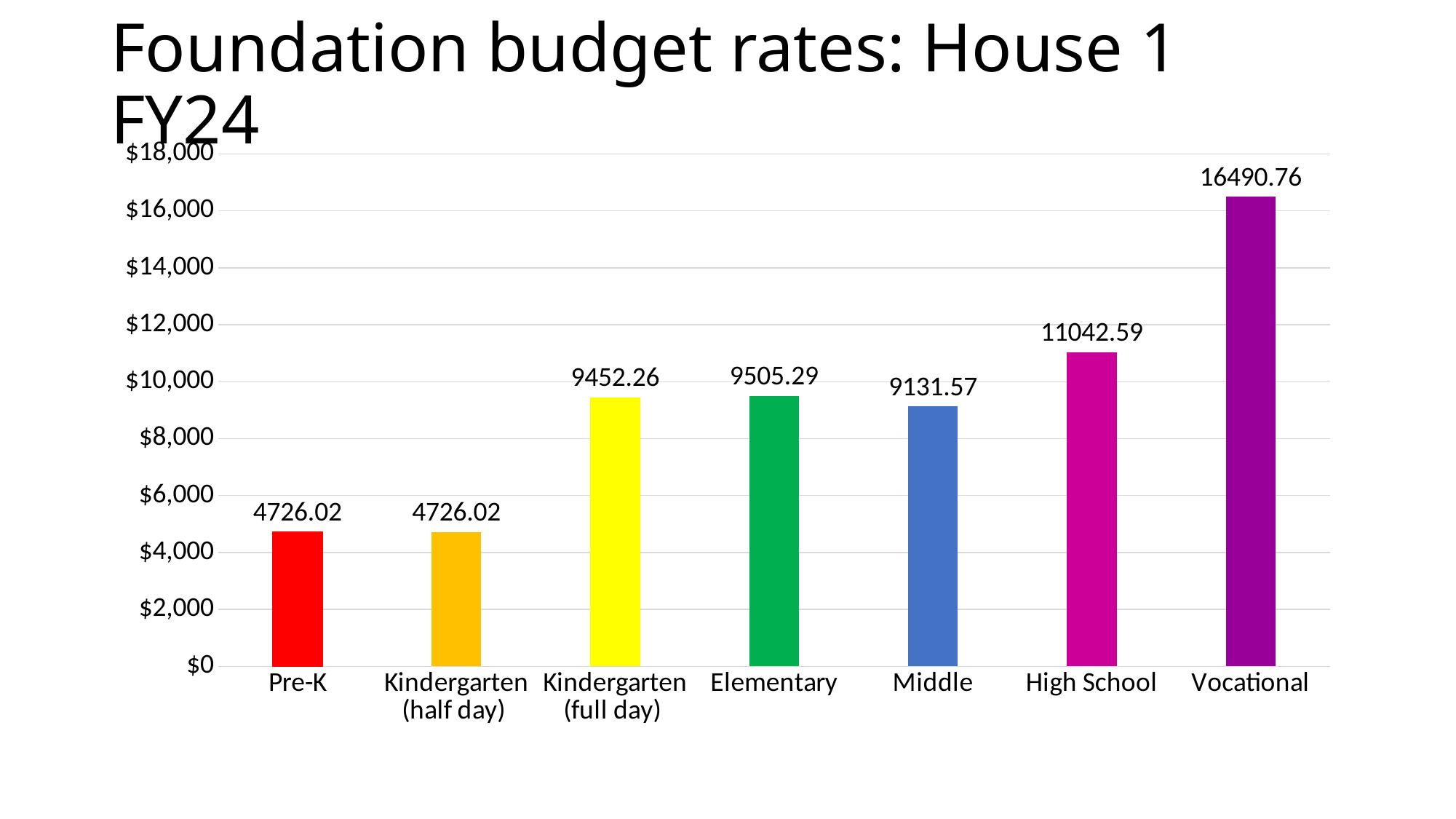
What is the difference between the values for High School and Middle? 1911.02 Which is larger, the value for Middle or the value for High School? High School What is the value for Vocational? 16490.76 What is the value for High School? 11042.59 How many categories are shown on the x axis? 7 What is the value for Kindergarten (full day)? 9452.26 What is the title of the chart? Foundation budget rates: House 1 FY24 Which category has the highest value? Vocational What kind of chart is shown on the slide? bar chart What is the value for Middle? 9131.57 What is the difference between the values for Vocational and High School? 5448.17 Is the value for Elementary greater or less than $8,000? greater